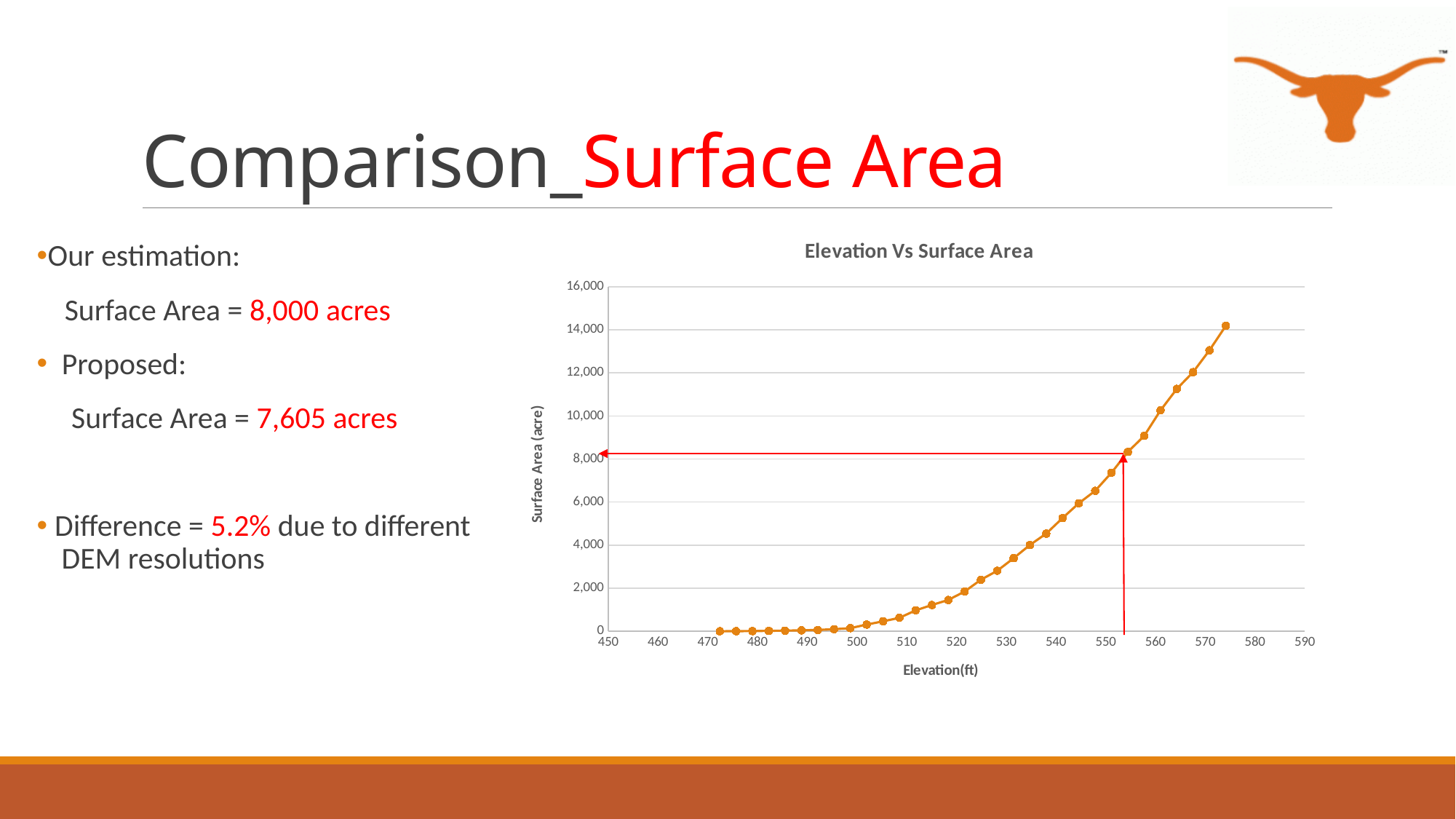
Is the surface area at an elevation of 510 ft greater or less than 2,000 acres? less Is the surface area at an elevation of 550 ft greater or less than 6,000 acres? greater What is the title of the chart? Elevation Vs Surface Area What kind of chart is shown on the slide? line chart Which has the larger surface area: an elevation of 540 ft or an elevation of 500 ft? 540 ft Is the surface area at an elevation of 480 ft greater or less than 2,000 acres? less Does surface area rise or fall as elevation increases along the x axis? rise What is the label of the x axis of the chart? Elevation(ft)